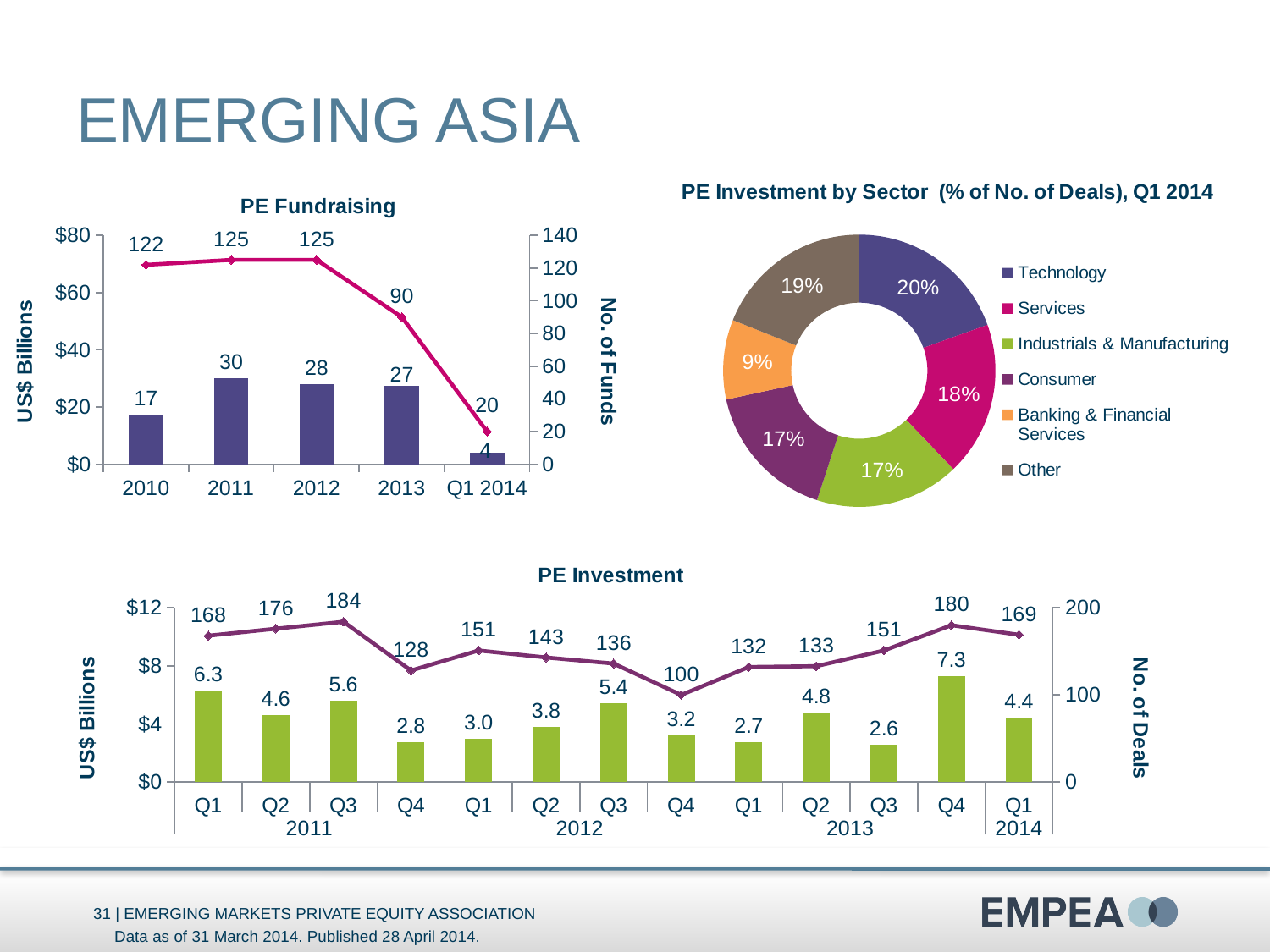
In the PE Fundraising chart, what is the difference in the number of funds between 2012 and 2013? 35 In the PE Investment chart, which is larger: the investment value for Q1 2011 or Q3 2011? Q1 2011 In the PE Fundraising chart, which year had the highest fundraising in US$ billions? 2011 In the PE Fundraising chart, what was the fundraising value in US$ billions for 2011? 30 In the PE Investment chart, what was the investment value in US$ billions for Q4 2013? 7.3 In the PE Fundraising chart, how many funds were raised in 2013? 90 In the PE Investment by Sector chart, how many sectors does the legend list? 6 In the PE Investment by Sector chart, what share of deals was in Technology? 20% In the PE Fundraising chart, how many categories are shown on the x axis? 5 In the PE Investment chart, which quarter had the lowest number of deals? Q4 2012 In the PE Investment by Sector chart, which sector has the smallest share of deals? Banking & Financial Services In the PE Investment chart, what is the difference in the number of deals between Q3 2011 and Q4 2011? 56